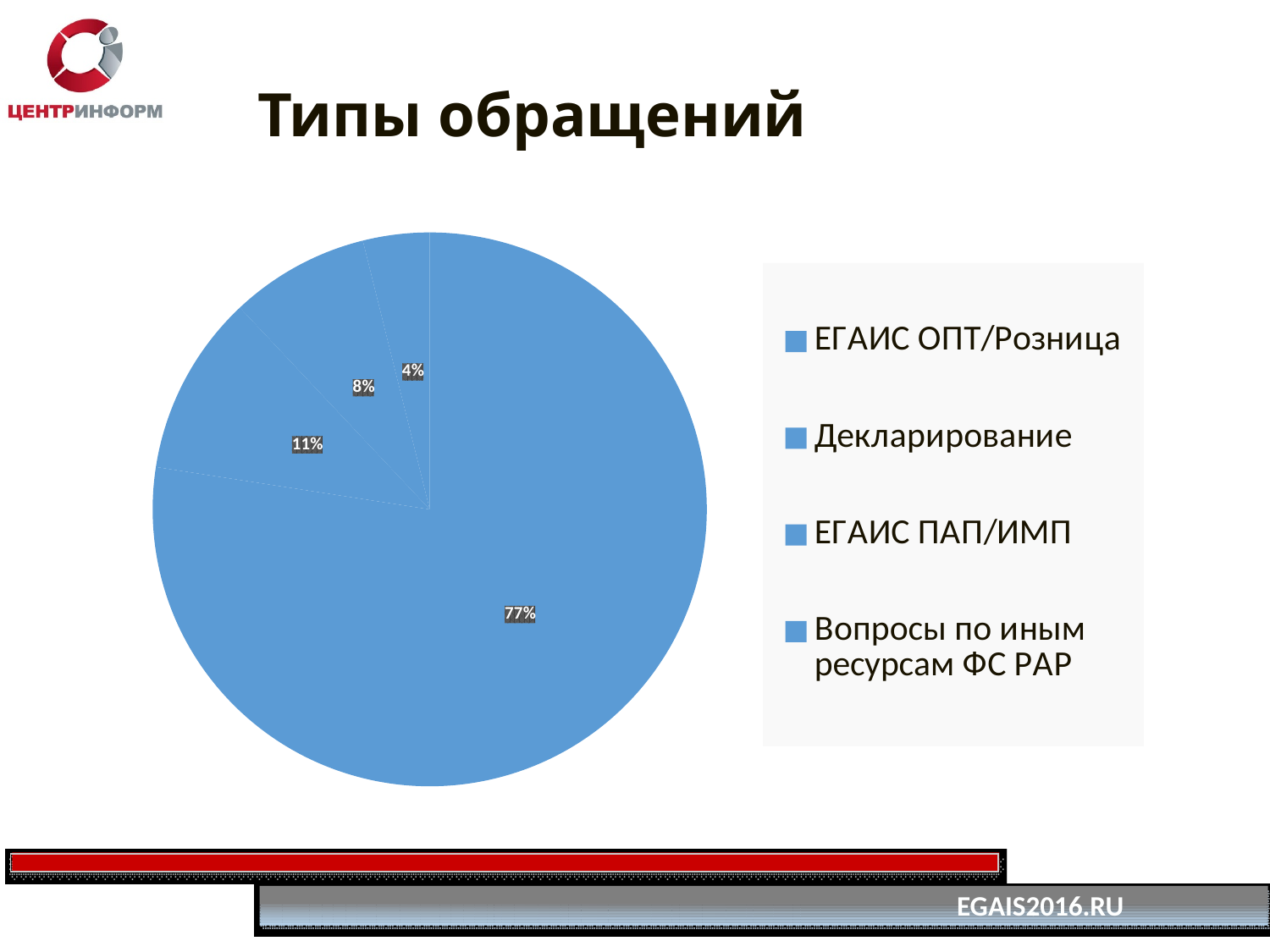
What do the four slice labels in the pie chart add up to? 100% What is the share of the smallest slice in the pie chart? 4% What is the share of the largest slice in the pie chart? 77% What is the difference in percentage points between the 11% slice and the 8% slice? 3 What is the title of the chart on the slide? Типы обращений What is the difference in percentage points between the largest slice (77%) and the smallest slice (4%)? 73 What kind of chart is shown on the slide? pie chart Which entry is listed first in the legend of the pie chart? ЕГАИС ОПТ/Розница How many slices does the pie chart have? 4 Which is larger, the slice labelled 11% or the slice labelled 8%? 11% How many entries does the legend of the pie chart list? 4 What is the second-largest share shown in the pie chart? 11%